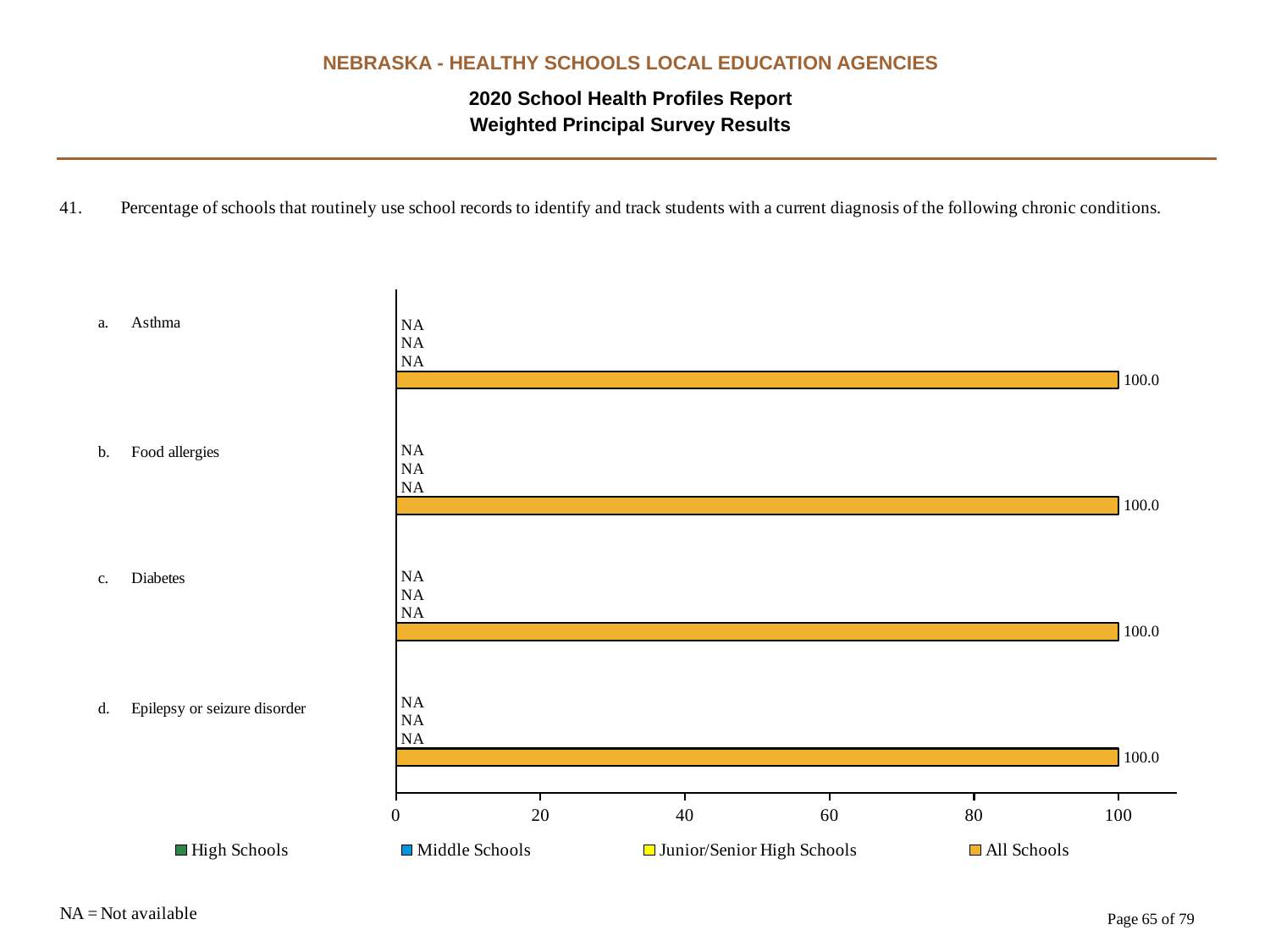
What kind of chart is shown on the slide? bar chart How many series does the legend list? 4 What is shown for High Schools for Food allergies? NA What is the value for All Schools for Diabetes? 100.0 How many chronic conditions (categories) are listed on the chart? 4 Which series is the last entry in the legend? All Schools What is shown for Middle Schools for Asthma? NA What is the difference between the All Schools values for Asthma and Food allergies? 0.0 Is the All Schools value for Diabetes greater or less than 80? greater What is the value for All Schools for Epilepsy or seizure disorder? 100.0 What does NA stand for according to the note on the slide? Not available What is the value for All Schools for Asthma? 100.0